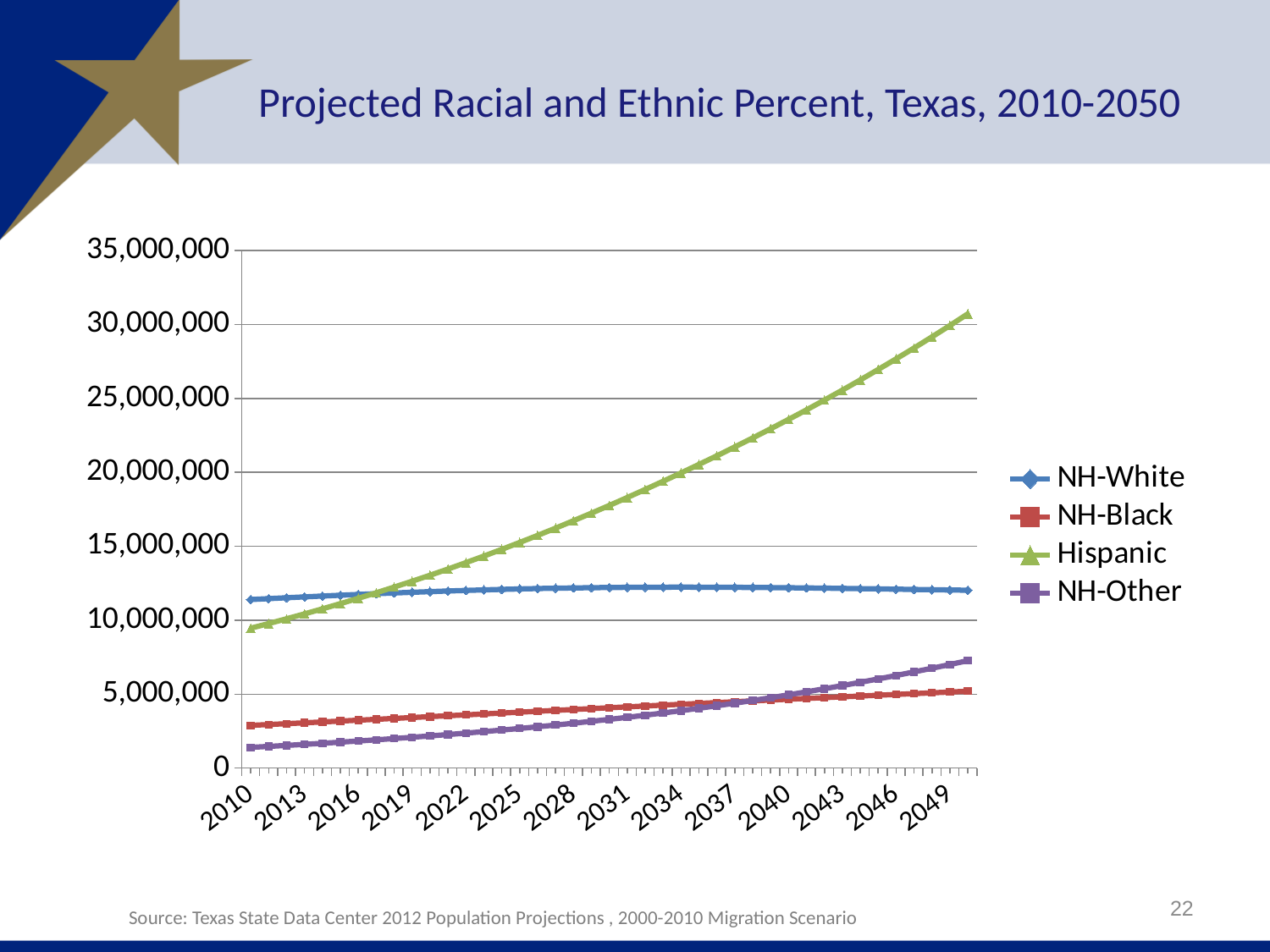
Is the value for NH-Other in 2050 greater or less than 5,000,000? greater What kind of chart is shown on the slide? Line chart Is the value for Hispanic in 2050 greater or less than 25,000,000? greater Is the value for Hispanic in 2010 greater or less than 10,000,000? less In 2010, which is larger: NH-White or Hispanic? NH-White Does the Hispanic series rise or fall from 2010 to 2050? Rise In 2050, which is larger: NH-Black or NH-Other? NH-Other Does the NH-Other series rise or fall from 2010 to 2050? Rise How many series does the legend list? 4 Which series has the highest value in 2050? Hispanic What is the title of the chart? Projected Racial and Ethnic Percent, Texas, 2010-2050 Which series has the lowest value in 2010? NH-Other